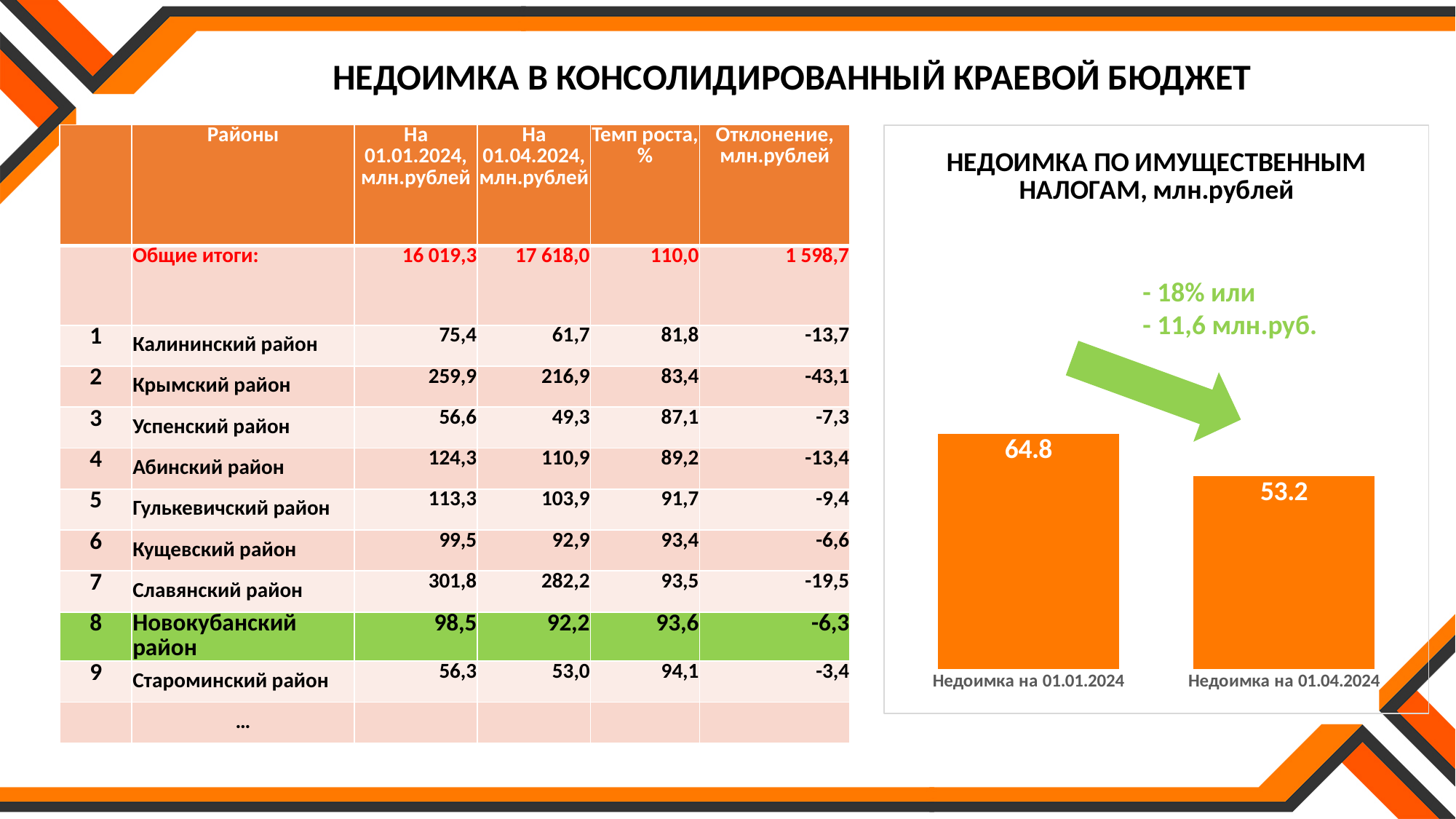
In the chart 'НЕДОИМКА ПО ИМУЩЕСТВЕННЫМ НАЛОГАМ', which is larger: the value for 'Недоимка на 01.01.2024' or the value for 'Недоимка на 01.04.2024'? Недоимка на 01.01.2024 In the chart 'НЕДОИМКА ПО ИМУЩЕСТВЕННЫМ НАЛОГАМ', which category has the lowest value? Недоимка на 01.04.2024 What type of chart is shown on the right side of the slide? bar chart In the chart 'НЕДОИМКА ПО ИМУЩЕСТВЕННЫМ НАЛОГАМ', which category has the highest value? Недоимка на 01.01.2024 In the chart 'НЕДОИМКА ПО ИМУЩЕСТВЕННЫМ НАЛОГАМ', what is the difference between the value for 'Недоимка на 01.01.2024' and the value for 'Недоимка на 01.04.2024'? 11.6 What percentage change is annotated next to the arrow in the chart 'НЕДОИМКА ПО ИМУЩЕСТВЕННЫМ НАЛОГАМ'? - 18% What is the title of the chart on the right side of the slide? НЕДОИМКА ПО ИМУЩЕСТВЕННЫМ НАЛОГАМ, млн.рублей In the chart 'НЕДОИМКА ПО ИМУЩЕСТВЕННЫМ НАЛОГАМ', what is the value for 'Недоимка на 01.04.2024'? 53.2 In the chart 'НЕДОИМКА ПО ИМУЩЕСТВЕННЫМ НАЛОГАМ', what is the value for 'Недоимка на 01.01.2024'? 64.8 How many bars are plotted in the chart 'НЕДОИМКА ПО ИМУЩЕСТВЕННЫМ НАЛОГАМ'? 2 In the chart 'НЕДОИМКА ПО ИМУЩЕСТВЕННЫМ НАЛОГАМ', do the values rise or fall from 01.01.2024 to 01.04.2024? fall